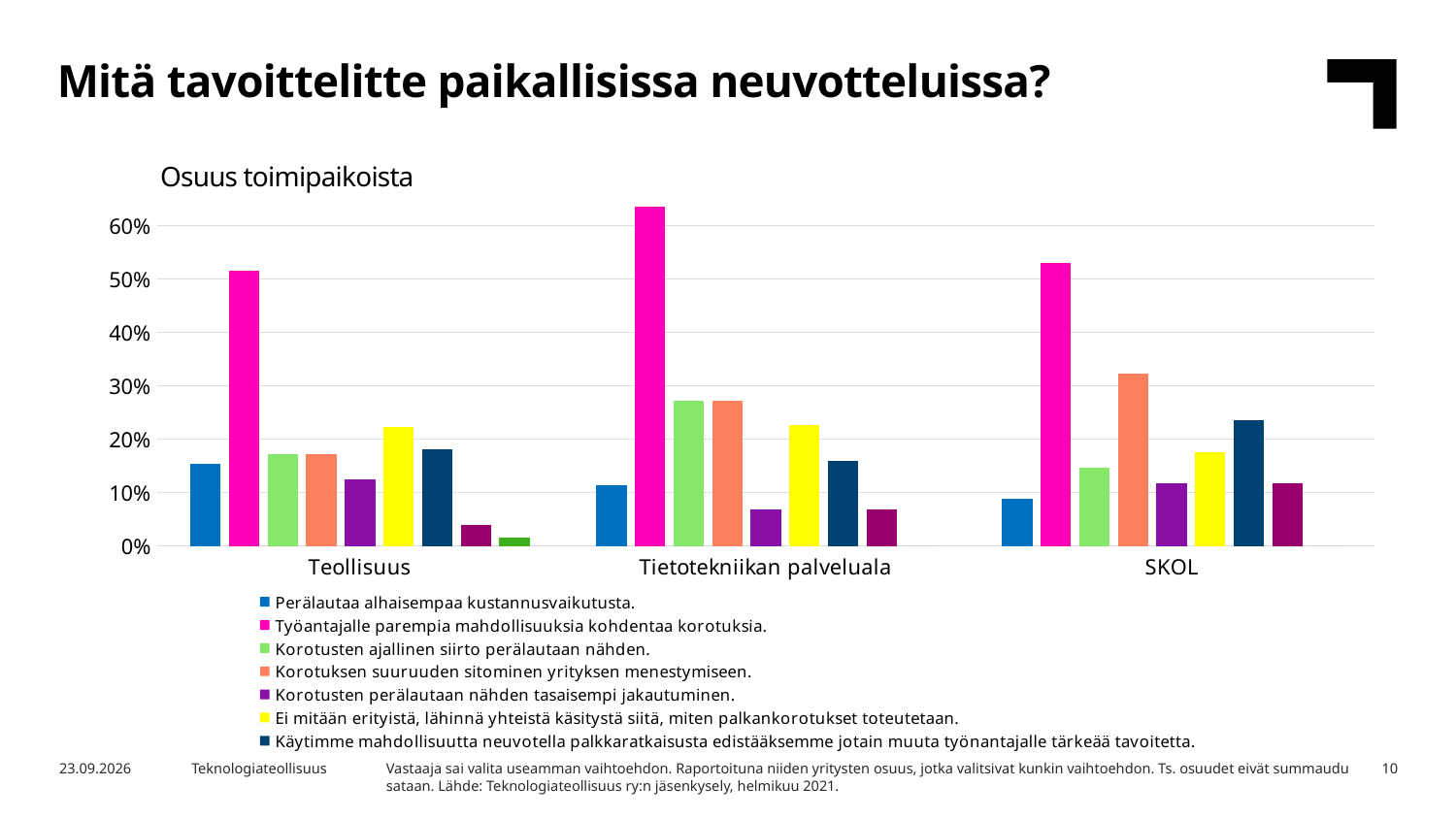
Which series has the highest value in the Tietotekniikan palveluala category? Työantajalle parempia mahdollisuuksia kohdentaa korotuksia. What kind of chart is shown on the slide? bar chart Is the value for 'Ei mitään erityistä, lähinnä yhteistä käsitystä siitä, miten palkankorotukset toteutetaan.' in Teollisuus greater or less than 20%? greater Which category has the larger value for 'Työantajalle parempia mahdollisuuksia kohdentaa korotuksia.': Teollisuus or Tietotekniikan palveluala? Tietotekniikan palveluala Is the value for 'Työantajalle parempia mahdollisuuksia kohdentaa korotuksia.' in Tietotekniikan palveluala greater or less than 60%? greater How many categories are shown on the x axis of the chart? 3 Is the value for 'Korotusten perälautaan nähden tasaisempi jakautuminen.' in Tietotekniikan palveluala greater or less than 10%? less Which category has the larger value for 'Perälautaa alhaisempaa kustannusvaikutusta.': Teollisuus or SKOL? Teollisuus What is the label shown above the chart's vertical axis? Osuus toimipaikoista Which series has the highest value in the SKOL category? Työantajalle parempia mahdollisuuksia kohdentaa korotuksia.